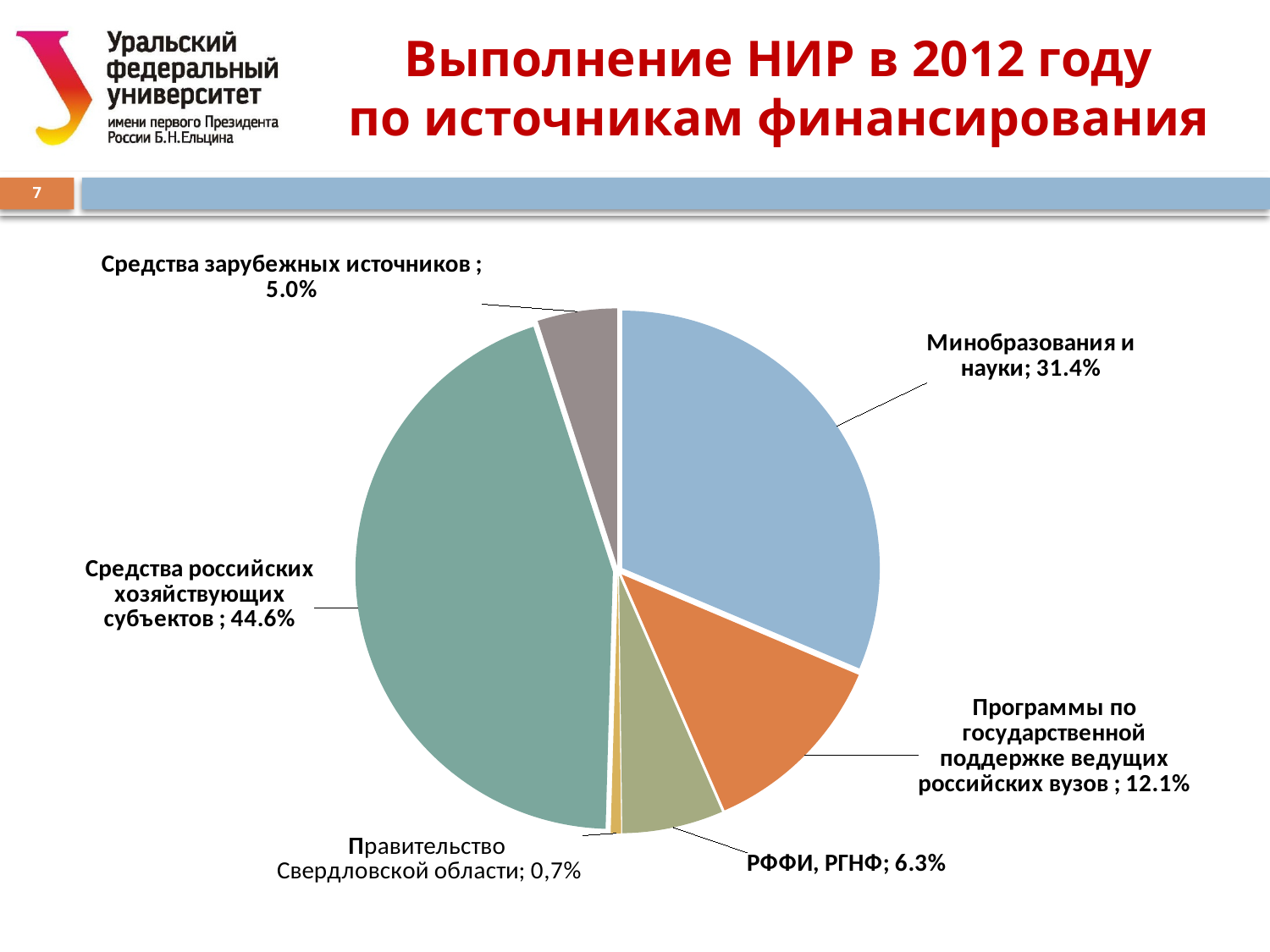
What type of chart is shown on the slide? pie chart What share of the pie is labelled "Минобразования и науки"? 31.4% What share is shown for "Средства зарубежных источников"? 5.0% How many slices does the pie chart have? 6 What share is shown for "Средства российских хозяйствующих субъектов"? 44.6% What percentage is shown for "РФФИ, РГНФ"? 6.3% Which funding source has the largest share of the pie? Средства российских хозяйствующих субъектов Which funding source has the smallest share of the pie? Правительство Свердловской области Which is larger: the share for "Программы по государственной поддержке ведущих российских вузов" or the share for "РФФИ, РГНФ"? Программы по государственной поддержке ведущих российских вузов What value is shown for "Правительство Свердловской области"? 0,7% What is the title of the slide containing the chart? Выполнение НИР в 2012 году по источникам финансирования What is the difference in percentage points between "Средства российских хозяйствующих субъектов" and "Минобразования и науки"? 13.2